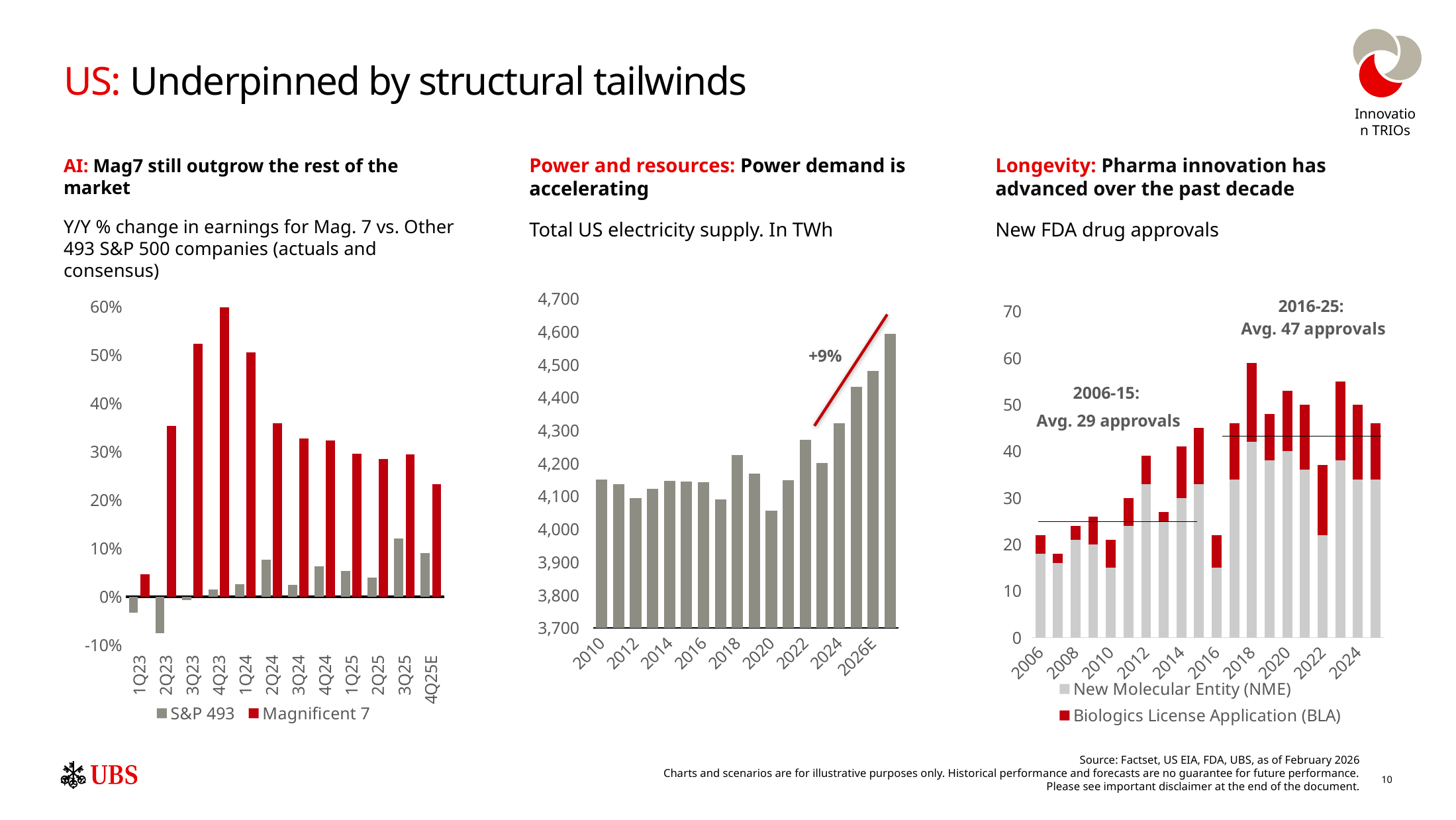
In the middle chart (Total US electricity supply), is the value for 2020 greater or less than 4,100? less In the left chart (Y/Y % change in earnings for Mag. 7 vs. Other 493 S&P 500 companies), how many series does the legend list? 2 In the right chart (New FDA drug approvals), what is the difference between the average approvals for 2016-25 and for 2006-15? 18 In the left chart (Y/Y % change in earnings), how many quarters are shown on the x axis? 12 In the left chart (Y/Y % change in earnings), is the Magnificent 7 value for 4Q23 greater or less than 50%? greater In the right chart (New FDA drug approvals), what kind of chart is it? Stacked bar chart In the left chart (Y/Y % change in earnings), in which quarter is the S&P 493 bar lowest? 2Q23 In the middle chart (Total US electricity supply), what percentage growth is annotated next to the red trend line? +9% In the right chart (New FDA drug approvals), which year has the tallest stacked bar? 2018 In the left chart (Y/Y % change in earnings), in which quarter is the Magnificent 7 bar highest? 4Q23